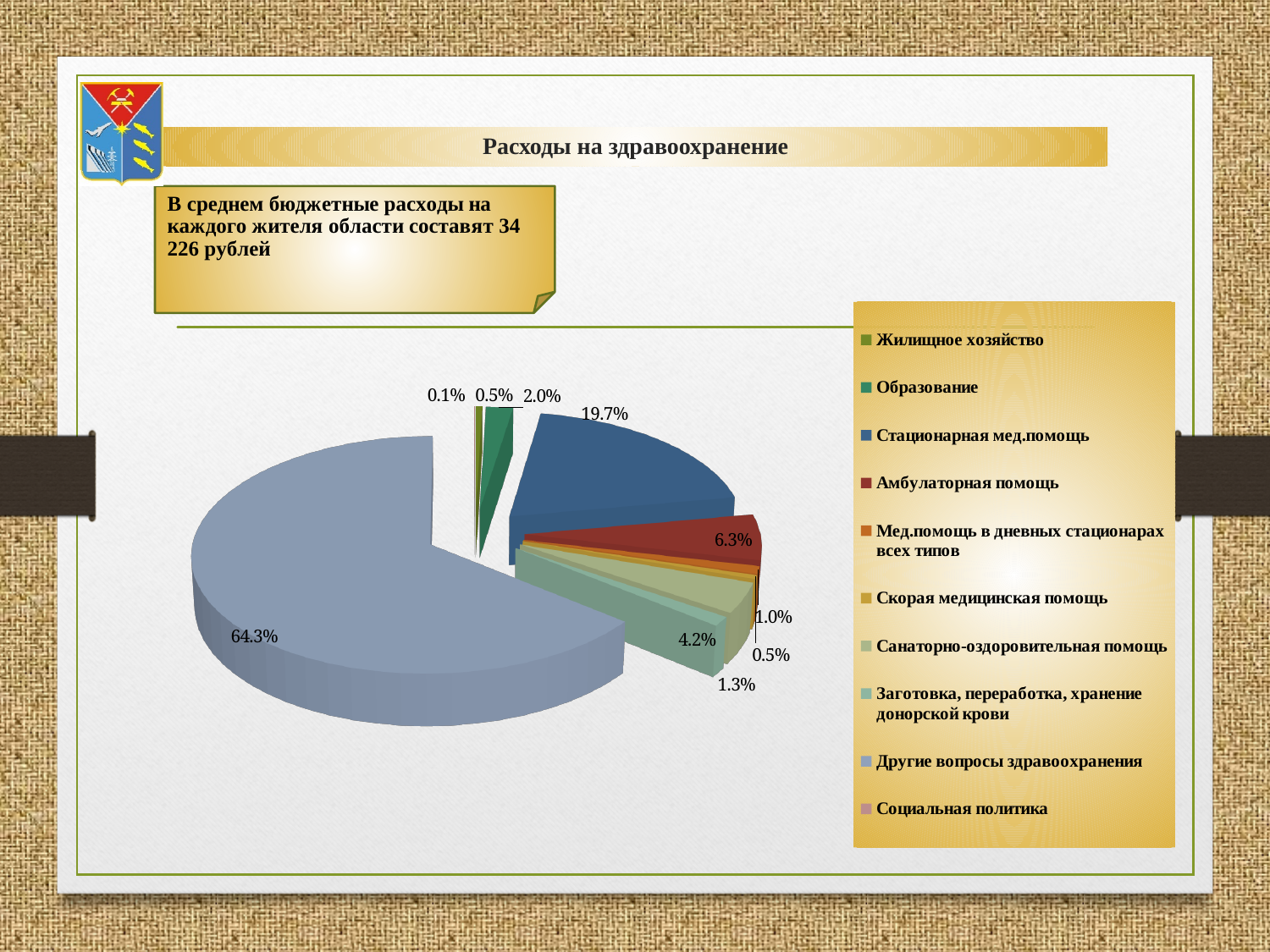
What share of the pie does Заготовка, переработка, хранение донорской крови have? 1.3% What kind of chart is shown on the slide? pie chart How many entries does the legend list? 10 What share of the pie does Санаторно-оздоровительная помощь have? 4.2% What is the title shown at the top of the slide? Расходы на здравоохранение What is the difference between the shares of Стационарная мед.помощь and Амбулаторная помощь? 13.4% Which category has the largest share of the pie? Другие вопросы здравоохранения What share of the pie does Другие вопросы здравоохранения have? 64.3% How many slices does the pie chart have? 10 Which is larger, the share of Санаторно-оздоровительная помощь or the share of Амбулаторная помощь? Амбулаторная помощь What share of the pie does Амбулаторная помощь have? 6.3% What share of the pie does Стационарная мед.помощь have? 19.7%